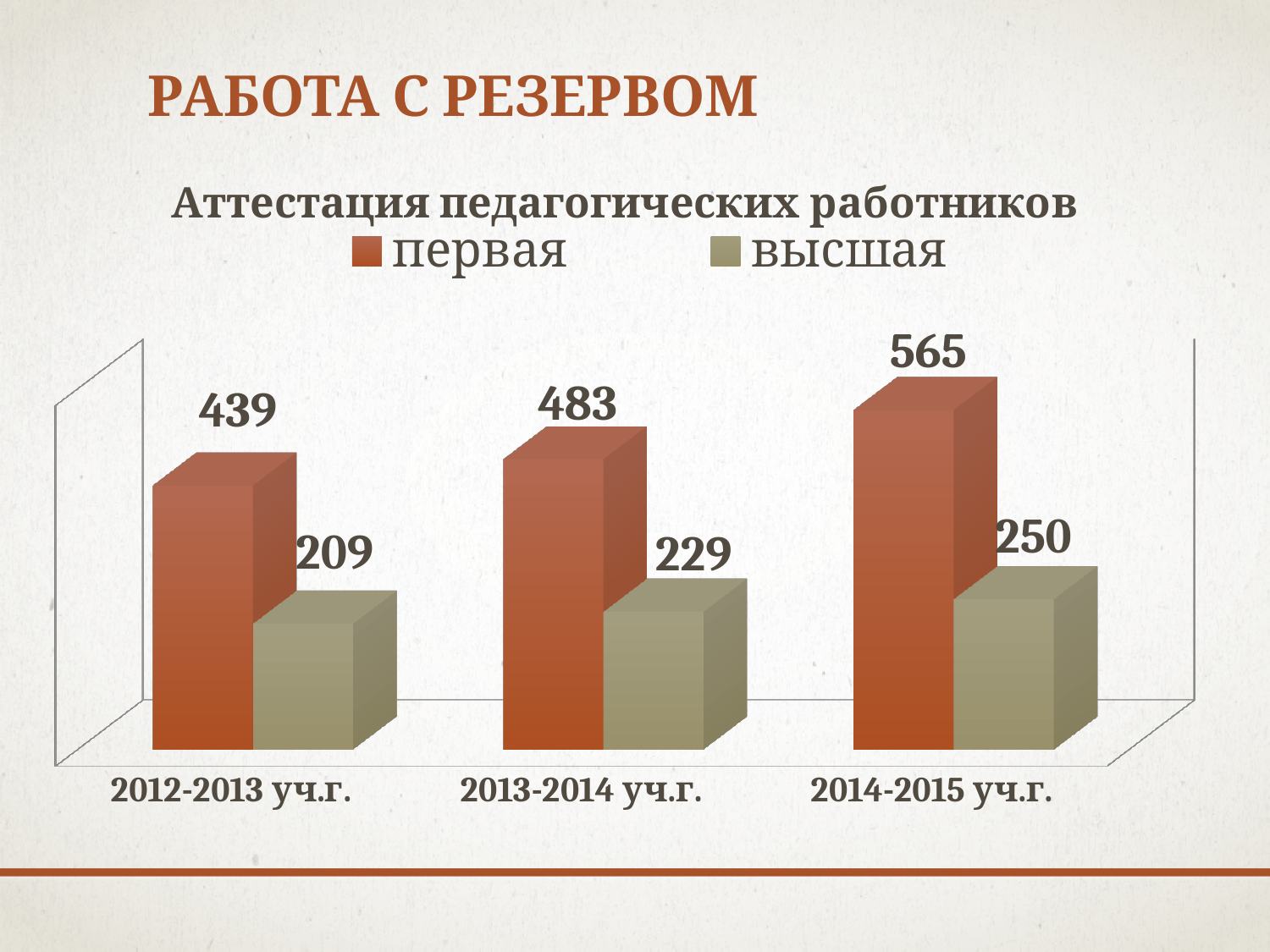
What is the difference between "первая" and "высшая" in 2014-2015 уч.г.? 315 Do the values for "первая" rise or fall from 2012-2013 to 2014-2015? rise How many series does the legend list? 2 What is the value for "высшая" in 2013-2014 уч.г.? 229 What kind of chart is shown? bar chart What is the value for "первая" in 2014-2015 уч.г.? 565 Which is larger in 2013-2014 уч.г., "первая" or "высшая"? первая In which year is the value for "высшая" lowest? 2012-2013 уч.г. What is the value for "высшая" in 2012-2013 уч.г.? 209 How many year categories are shown on the x axis? 3 What is the value for "первая" in 2012-2013 уч.г.? 439 In which year is the value for "первая" highest? 2014-2015 уч.г.